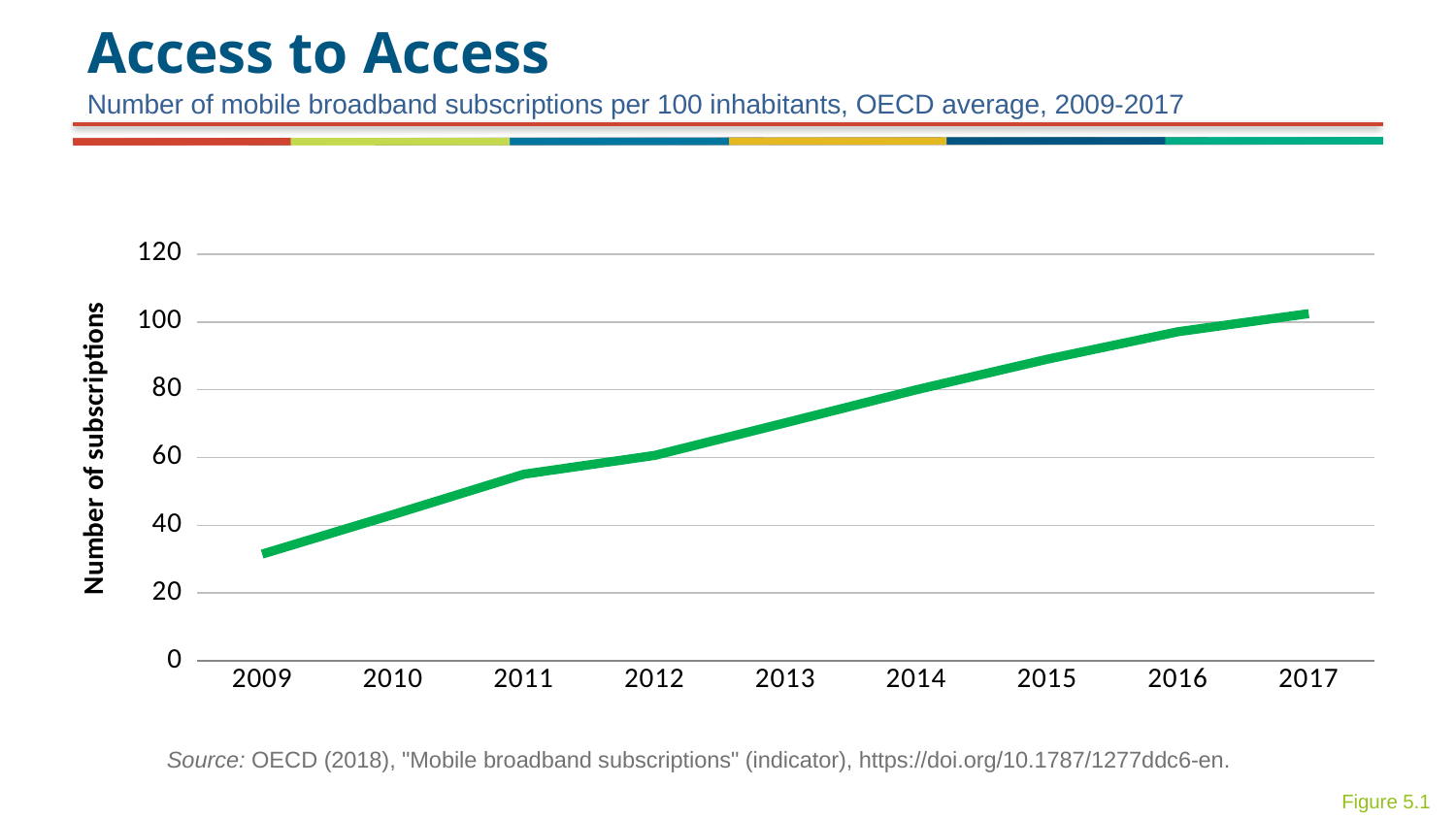
Which year has the lowest number of subscriptions? 2009 How many years are plotted along the x axis? 9 Which year has the highest number of subscriptions? 2017 Is the value for 2010 greater or less than 60? less Do the values rise or fall from 2009 to 2017? Rise Is the value for 2015 greater or less than 80? greater Is the value for 2009 greater or less than 40? less What kind of chart is shown on the slide? Line chart What is the label on the vertical axis? Number of subscriptions Which year has the larger value, 2011 or 2015? 2015